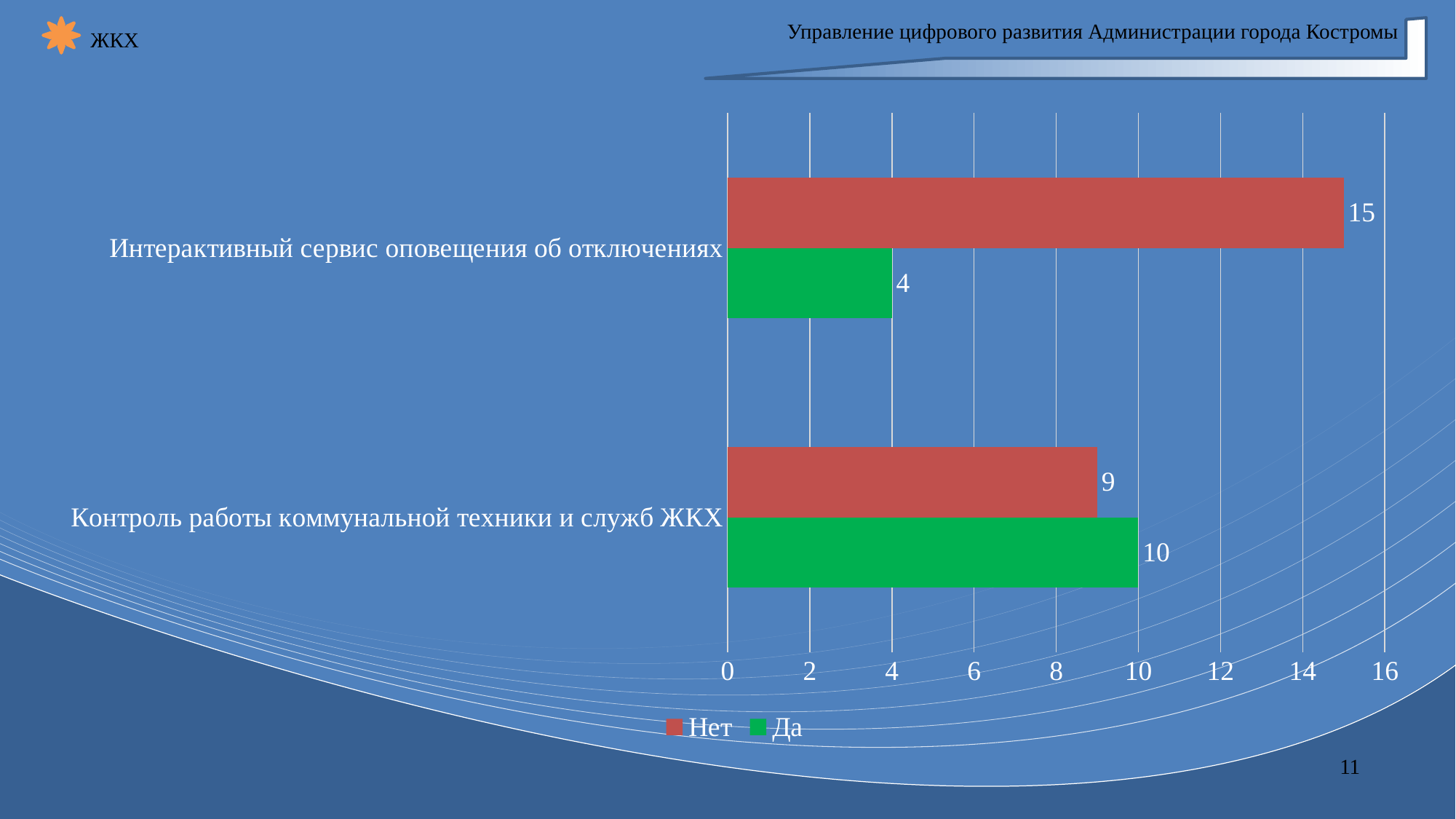
How many series does the legend list? 2 What is the value of "Да" for "Контроль работы коммунальной техники и служб ЖКХ"? 10 Which category has the lowest "Да" value? Интерактивный сервис оповещения об отключениях What is the value of "Нет" for "Контроль работы коммунальной техники и служб ЖКХ"? 9 Which colour represents the "Да" series in the legend? Green How many categories are shown on the chart? 2 Which category has the highest "Нет" value? Интерактивный сервис оповещения об отключениях What kind of chart is shown on the slide? Bar chart What is the value of "Да" for "Интерактивный сервис оповещения об отключениях"? 4 What is the difference between the "Нет" and "Да" values for "Интерактивный сервис оповещения об отключениях"? 11 For "Контроль работы коммунальной техники и служб ЖКХ", which is larger: "Нет" or "Да"? Да What is the value of "Нет" for "Интерактивный сервис оповещения об отключениях"? 15